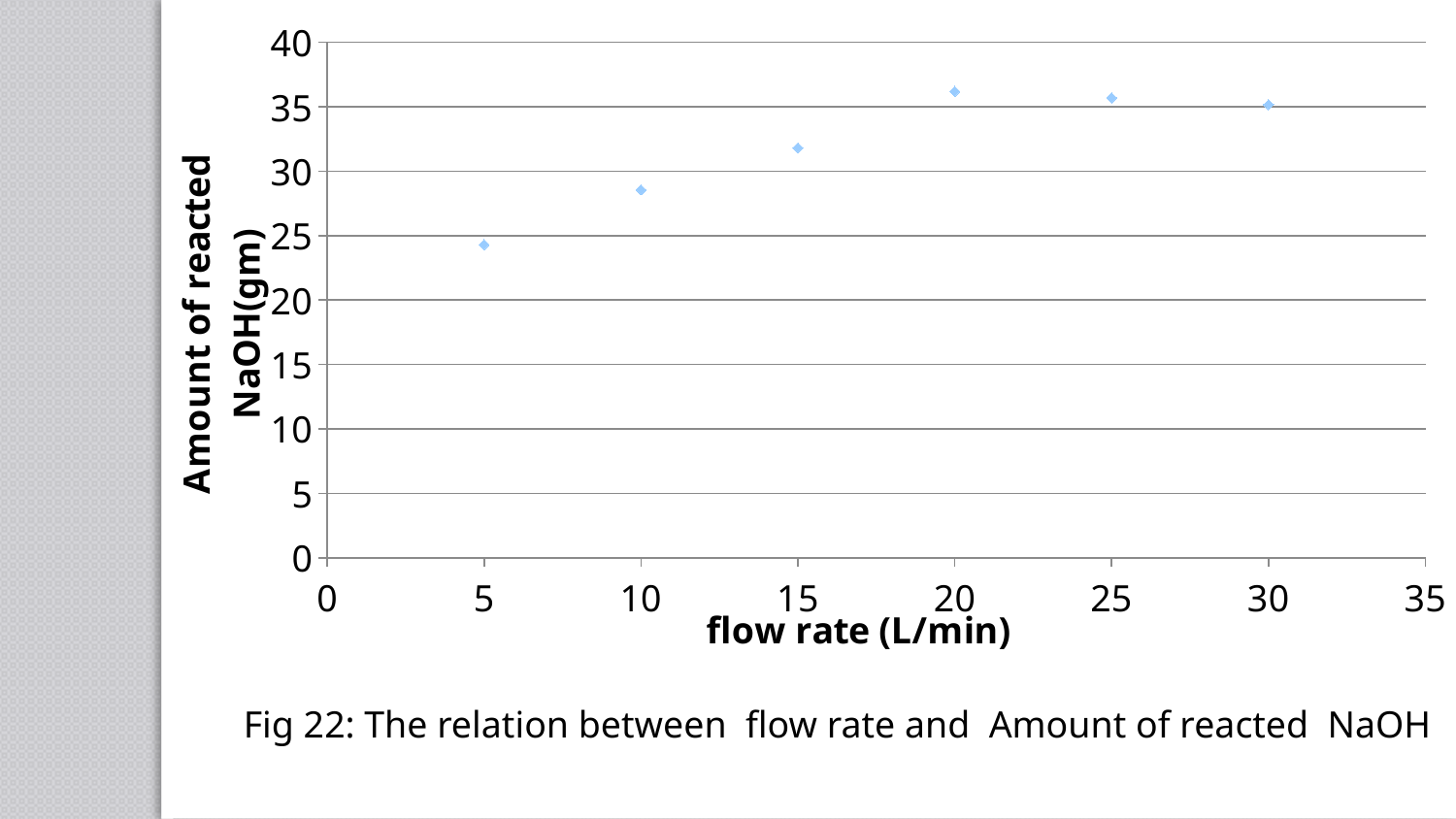
What kind of chart is shown on the slide? scatter chart What is the figure caption below the chart? Fig 22: The relation between flow rate and Amount of reacted NaOH Which flow rate has the lowest amount of reacted NaOH? 5 L/min How many data points are plotted on the chart? 6 What is the label of the x axis? flow rate (L/min) Is the amount of reacted NaOH at a flow rate of 15 L/min greater or less than 30? greater Does the amount of reacted NaOH rise or fall as the flow rate increases from 5 to 20 L/min? rises Which has a larger amount of reacted NaOH: a flow rate of 5 L/min or 30 L/min? 30 L/min Is the amount of reacted NaOH at a flow rate of 20 L/min greater or less than 35? greater Is the amount of reacted NaOH at a flow rate of 30 L/min greater or less than 30? greater